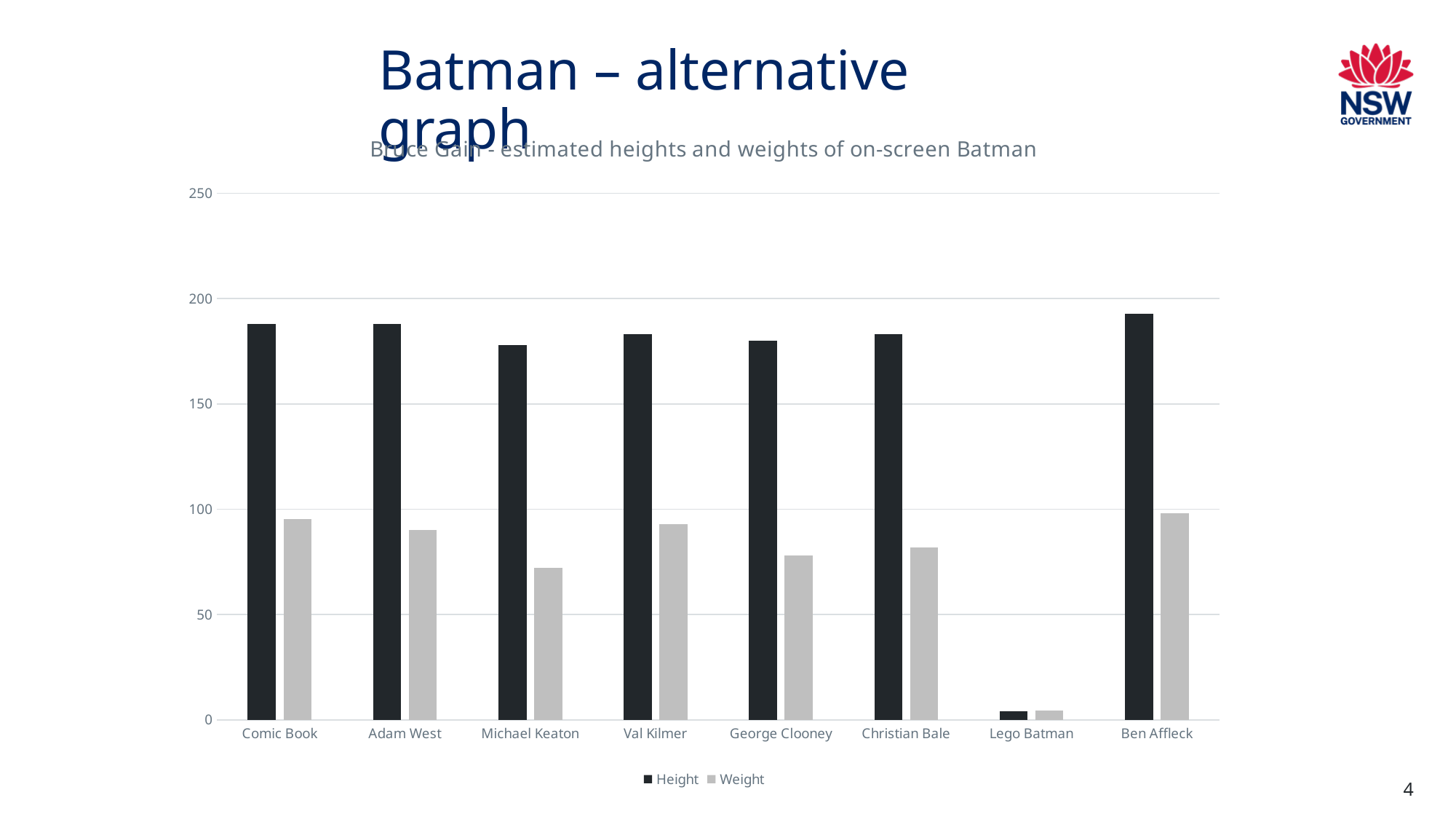
Which is larger, the Height value for Michael Keaton or the Height value for Ben Affleck? Ben Affleck How many categories are shown on the x axis of the chart? 8 Is the Weight value for Michael Keaton greater or less than 100? less Is the Height value for Michael Keaton greater or less than 150? greater What kind of chart is shown on the slide? bar chart How many series does the chart's legend list? 2 What are the two series named in the chart's legend? Height and Weight Is the Height value for Ben Affleck greater or less than 200? less Which category has the highest Height bar? Ben Affleck Which category has the lowest Weight bar? Lego Batman Which category has the lowest Height bar? Lego Batman Which is larger, the Weight value for Michael Keaton or the Weight value for Val Kilmer? Val Kilmer